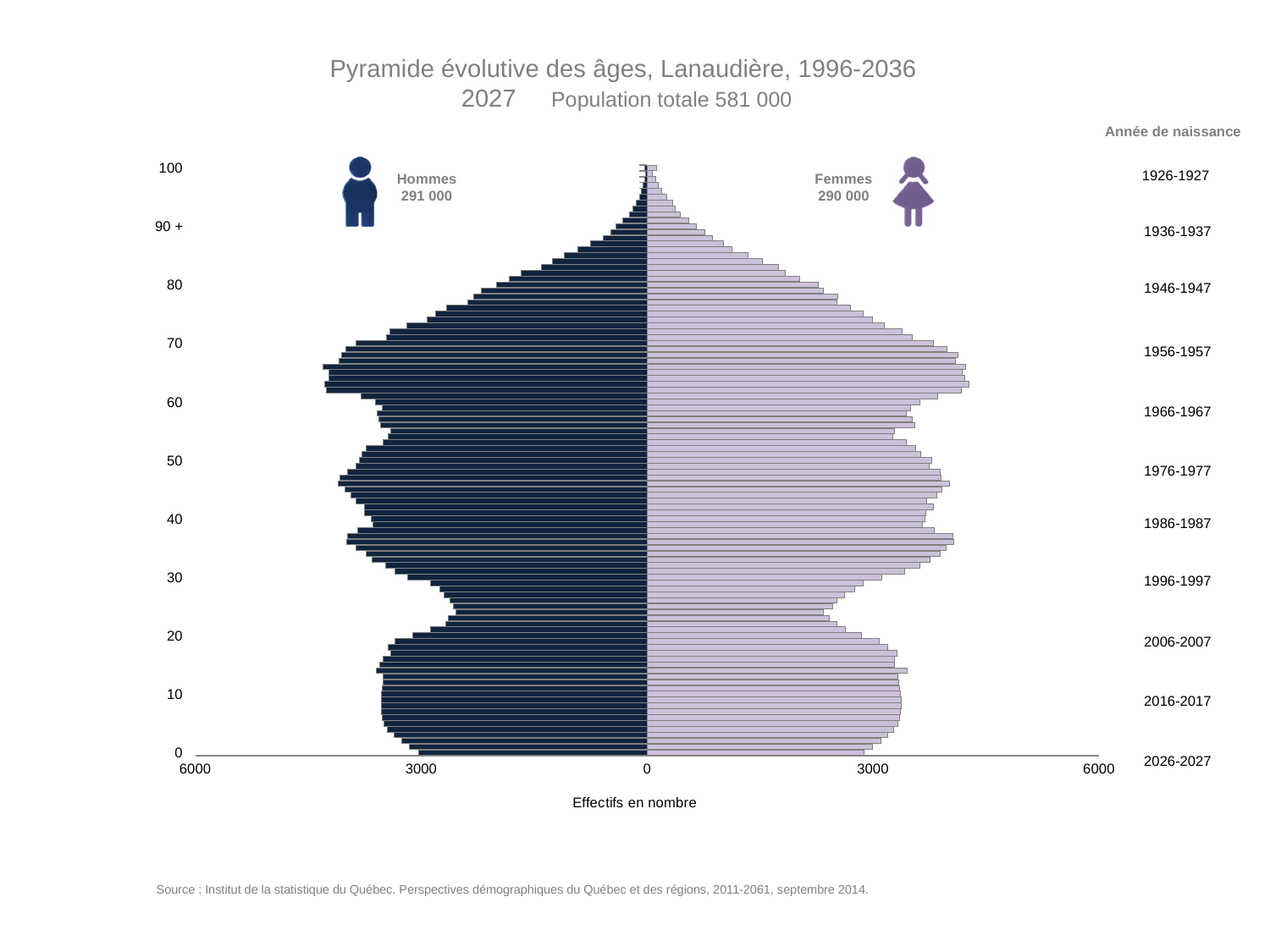
Is the value for Hommes at age 65 greater or less than 3000? greater What kind of chart is shown on the slide? bar chart (population pyramid) Which group has the larger total, Hommes or Femmes? Hommes What is the title of the chart? Pyramide évolutive des âges, Lanaudière, 1996-2036 What is the label of the horizontal axis? Effectifs en nombre What is the maximum value shown on the horizontal axis? 6000 What is the difference between the Hommes total and the Femmes total? 1 000 What total population is shown for 2027? 581 000 Is the value for Femmes at age 85 greater or less than 3000? less What is the total number of Hommes shown on the chart? 291 000 What is the total number of Femmes shown on the chart? 290 000 Is the value for Hommes at age 25 greater or less than 3000? less